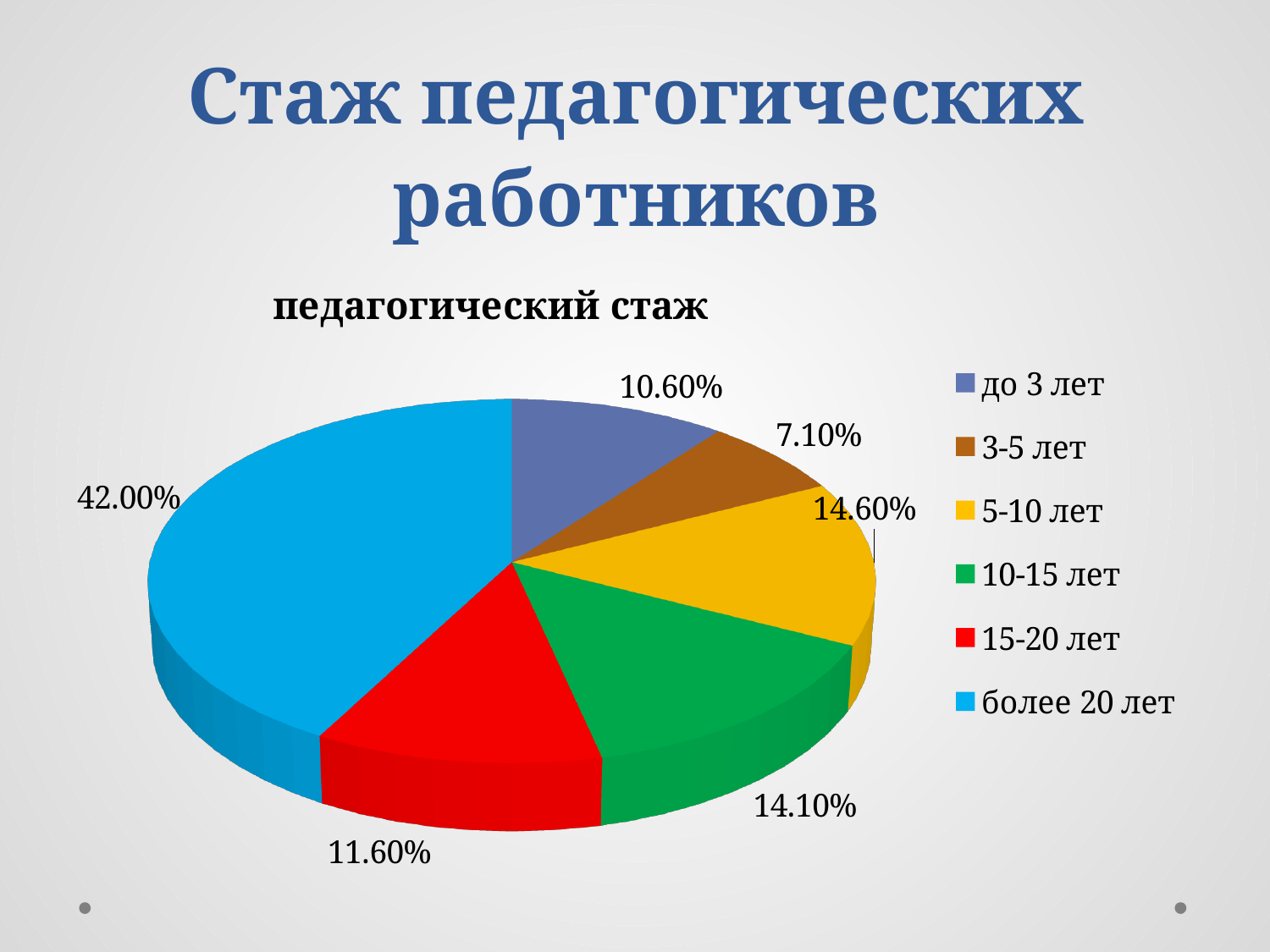
What is the value for '5-10 лет'? 14.60% What kind of chart is shown on the slide? pie chart What is the difference between the values for 'более 20 лет' and '10-15 лет'? 27.90% How many categories does the legend list? 6 What is the value for '15-20 лет'? 11.60% What is the value for 'до 3 лет'? 10.60% What is the value for '3-5 лет'? 7.10% What is the value for 'более 20 лет'? 42.00% Which is larger, the value for '5-10 лет' or the value for '15-20 лет'? 5-10 лет Which category has the smallest share? 3-5 лет Which category has the largest share? более 20 лет What is the chart's title? педагогический стаж